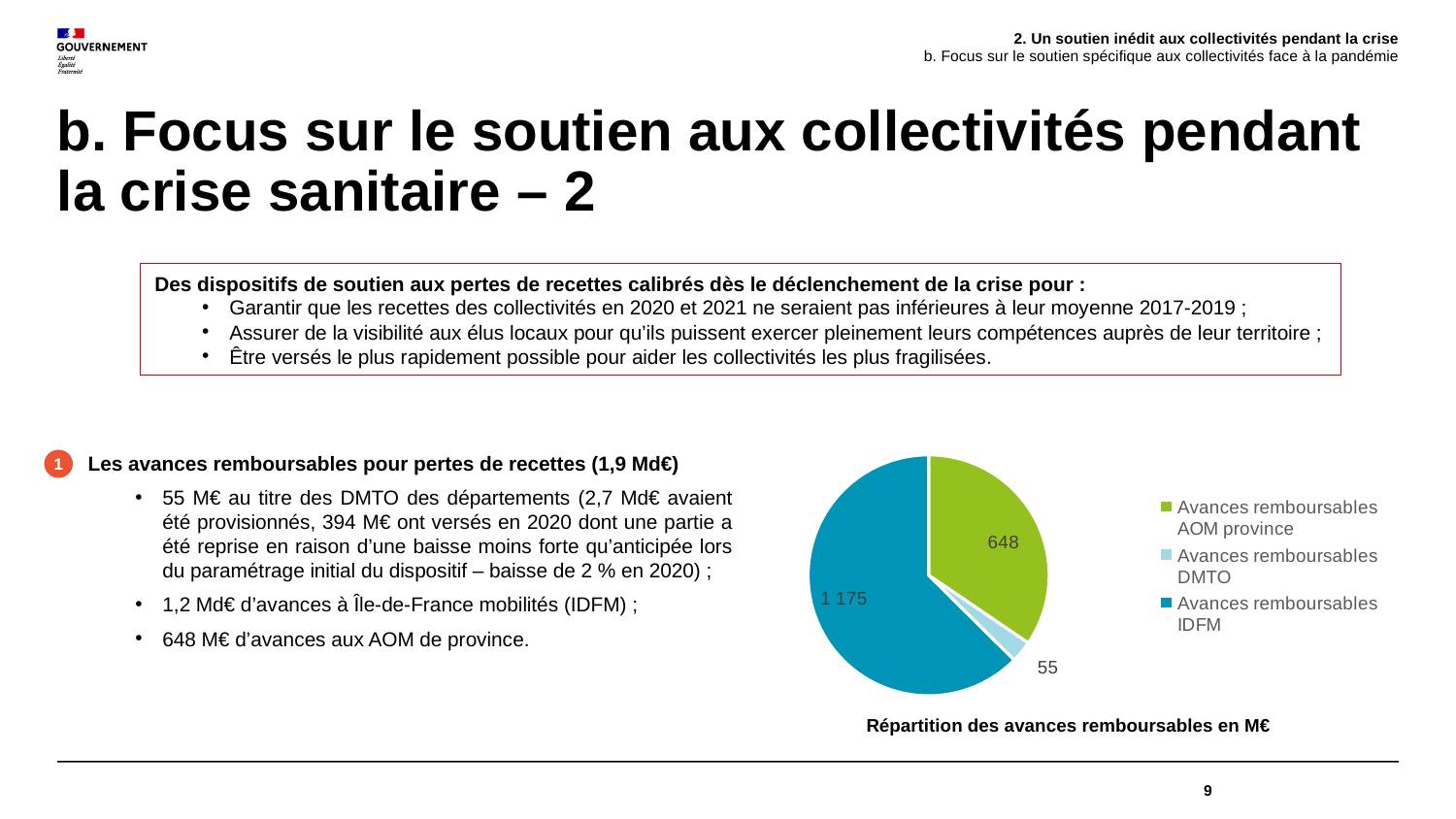
What is the value for Avances remboursables AOM province in the pie chart? 648 Which category has the largest slice in the pie chart? Avances remboursables IDFM What is the value for Avances remboursables IDFM in the pie chart? 1 175 Which category has the smallest slice in the pie chart? Avances remboursables DMTO What is the value for Avances remboursables DMTO in the pie chart? 55 What is the total of all the values shown in the pie chart? 1 878 How many slices does the pie chart have? 3 What is the caption printed below the pie chart? Répartition des avances remboursables en M€ What type of chart is shown on the slide? pie chart What is the difference between the values for Avances remboursables IDFM and Avances remboursables AOM province? 527 What is the difference between the values for Avances remboursables AOM province and Avances remboursables DMTO? 593 Which is larger: Avances remboursables AOM province or Avances remboursables DMTO? Avances remboursables AOM province